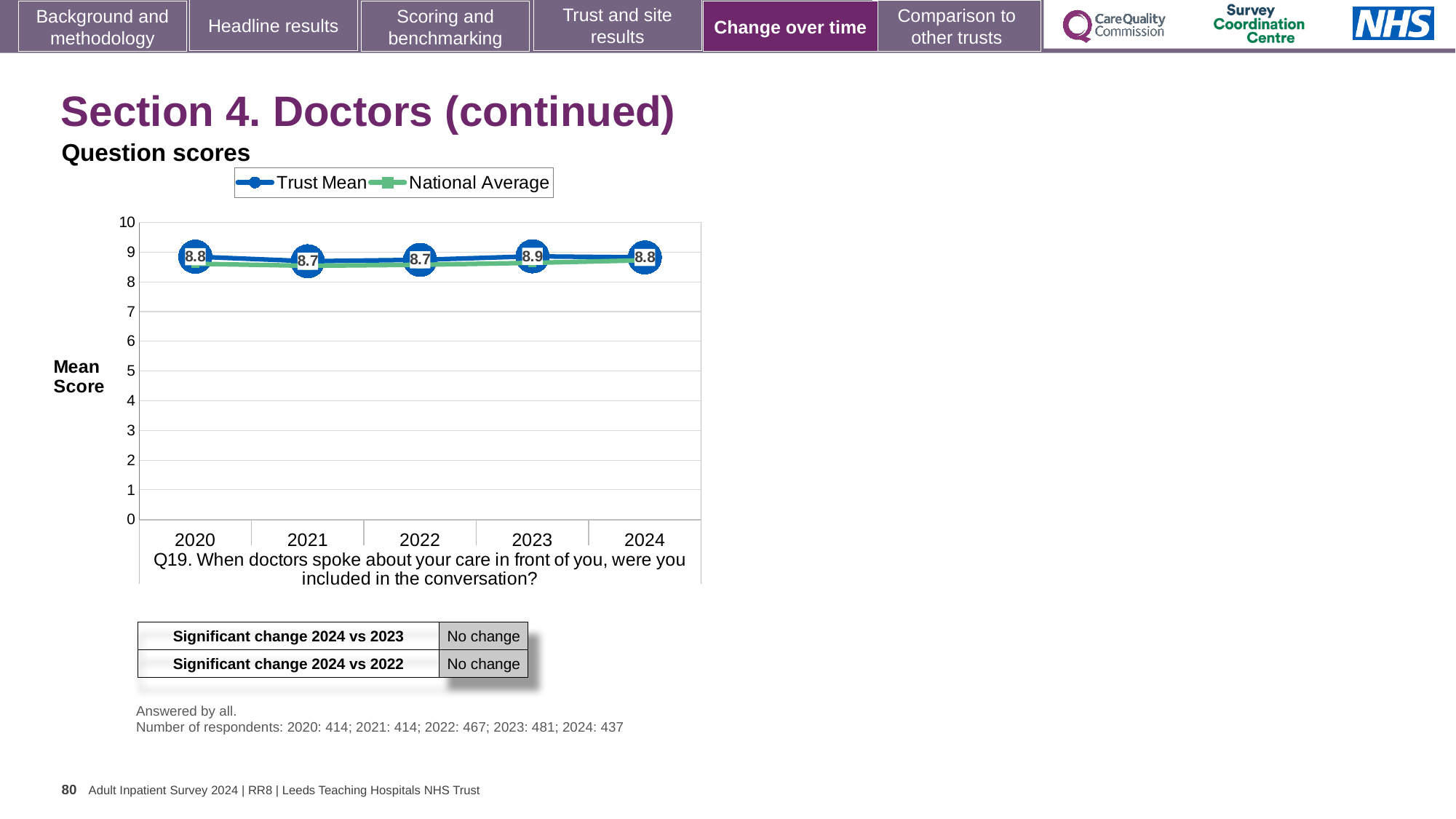
In which year is the Trust Mean score highest? 2023 How many series does the legend list? 2 Is the National Average value for 2021 greater or less than 8? greater What is the Trust Mean score for 2020? 8.8 What is the Trust Mean score for 2022? 8.7 What are the two series named in the legend? Trust Mean and National Average What kind of chart is shown on the slide? Line chart What is the label on the y axis of the chart? Mean Score What is the difference between the Trust Mean scores for 2023 and 2021? 0.2 How many years are plotted on the x axis? 5 What is the Trust Mean score for 2023? 8.9 Which year has the larger Trust Mean score, 2023 or 2022? 2023